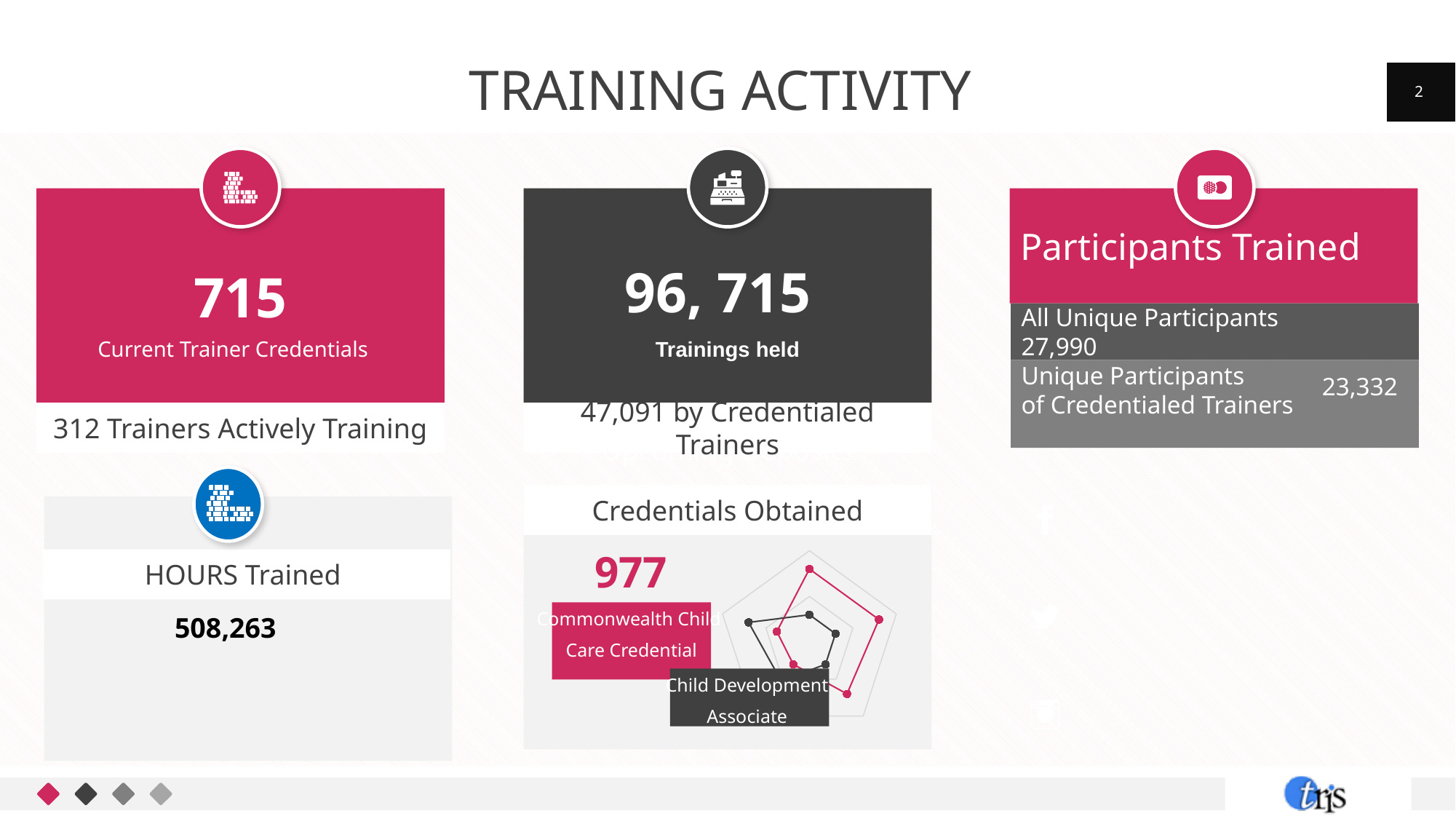
How many series are plotted on the "Credentials Obtained" radar chart? 2 How many points (axes) does each series on the "Credentials Obtained" radar chart have? 5 What is the title of the chart section containing the radar chart? Credentials Obtained What kind of chart is shown under the "Credentials Obtained" heading? radar chart On the "Credentials Obtained" radar chart, which series extends further from the centre on every axis, the pink one or the dark grey one? neither; the pink series extends further on three axes and the dark grey series on the other two What two colours are used for the series on the "Credentials Obtained" radar chart? pink and dark grey